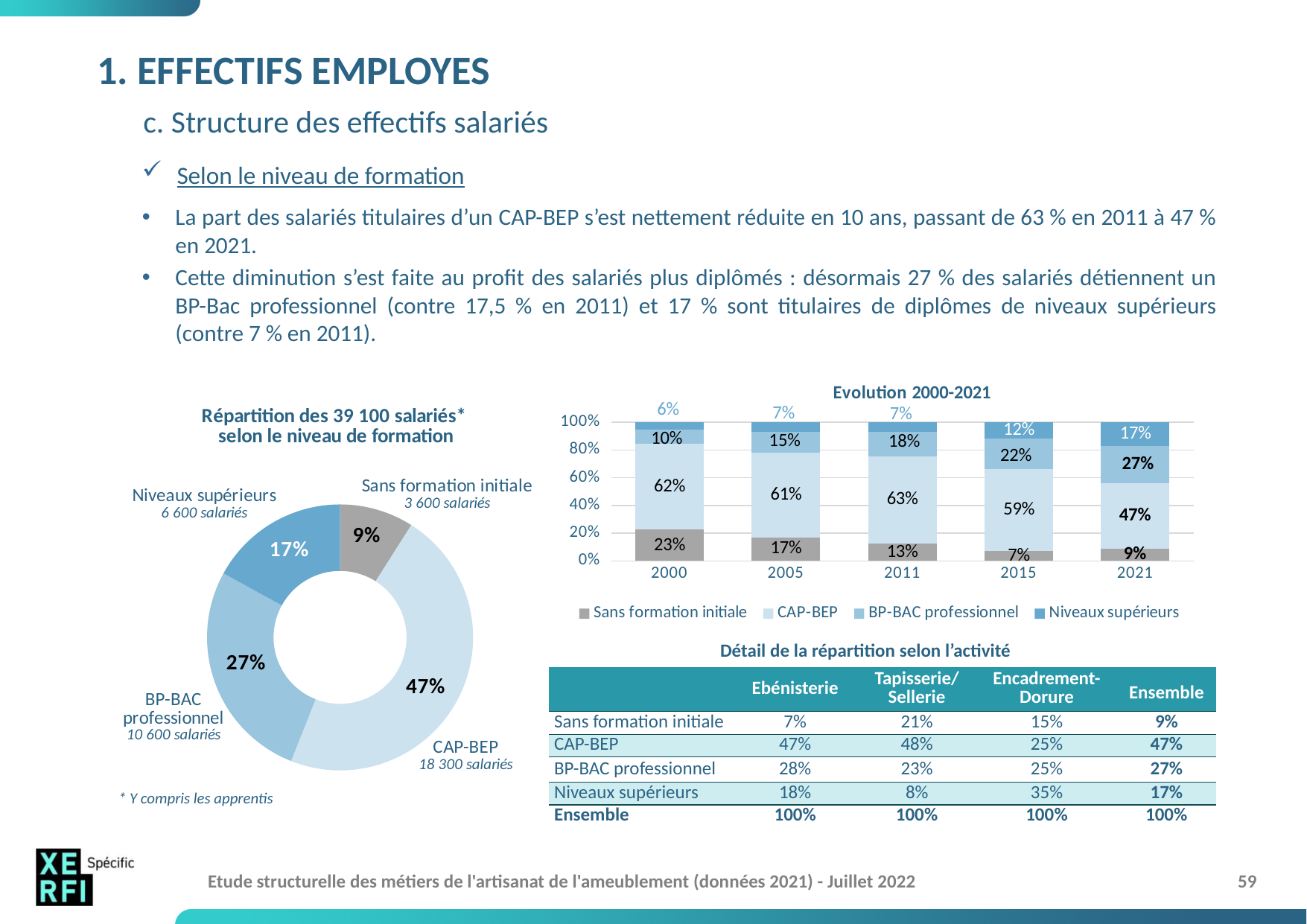
In the chart 'Répartition des 39 100 salariés* selon le niveau de formation', which category has the largest share? CAP-BEP In the chart 'Evolution 2000-2021', is the share of CAP-BEP larger in 2005 or in 2021? 2005 In the chart 'Répartition des 39 100 salariés* selon le niveau de formation', which category has the smallest share? Sans formation initiale In the chart 'Evolution 2000-2021', does the share of 'BP-BAC professionnel' rise or fall from 2000 to 2021? Rise In the chart 'Répartition des 39 100 salariés* selon le niveau de formation', how many employees are in the 'BP-BAC professionnel' category? 10 600 salariés In the chart 'Evolution 2000-2021', by how many percentage points did the share of 'Niveaux supérieurs' increase between 2011 and 2021? 10 percentage points In the chart 'Evolution 2000-2021', how many series does the legend list? 4 In the chart 'Evolution 2000-2021', what is the share of CAP-BEP in 2000? 62% In the chart 'Evolution 2000-2021', how many years are shown on the x axis? 5 In the chart 'Evolution 2000-2021', what is the share of 'Sans formation initiale' in 2015? 7% In the chart 'Répartition des 39 100 salariés* selon le niveau de formation', what kind of chart is used? Doughnut (pie) chart In the chart 'Répartition des 39 100 salariés* selon le niveau de formation', what share of employees hold a CAP-BEP? 47%